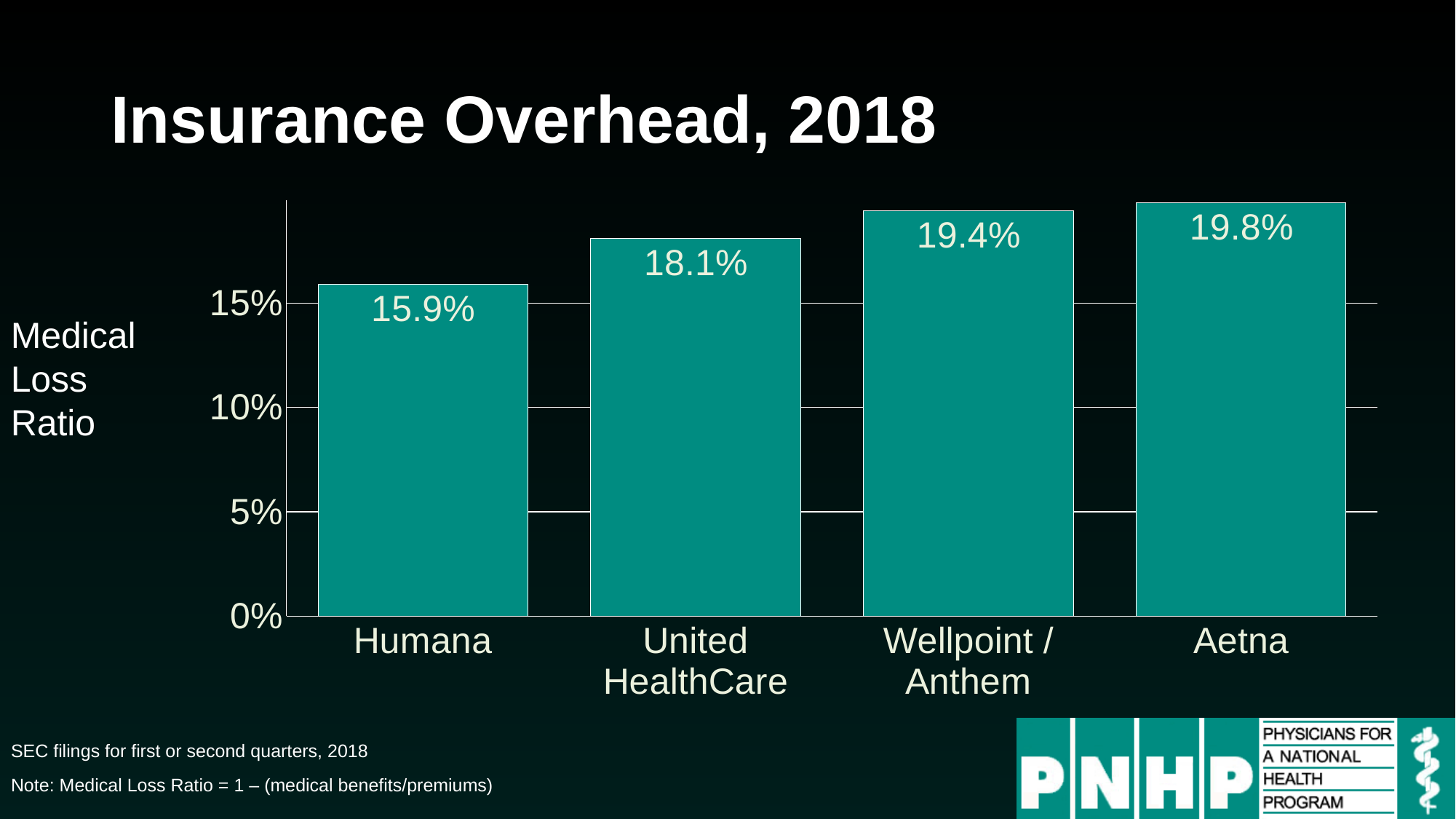
What is the difference between the values for Wellpoint / Anthem and United HealthCare? 1.3% Which insurer has the highest value? Aetna What is the value for Humana? 15.9% What kind of chart is shown on the slide? Bar chart Do the values rise or fall from left to right across the insurers? Rise What is the value for United HealthCare? 18.1% Which is larger, the value for United HealthCare or the value for Humana? United HealthCare What is the difference between the values for Aetna and Humana? 3.9% What is the value for Aetna? 19.8% Which insurer has the lowest value? Humana How many insurers are shown in the chart? 4 What is the value for Wellpoint / Anthem? 19.4%